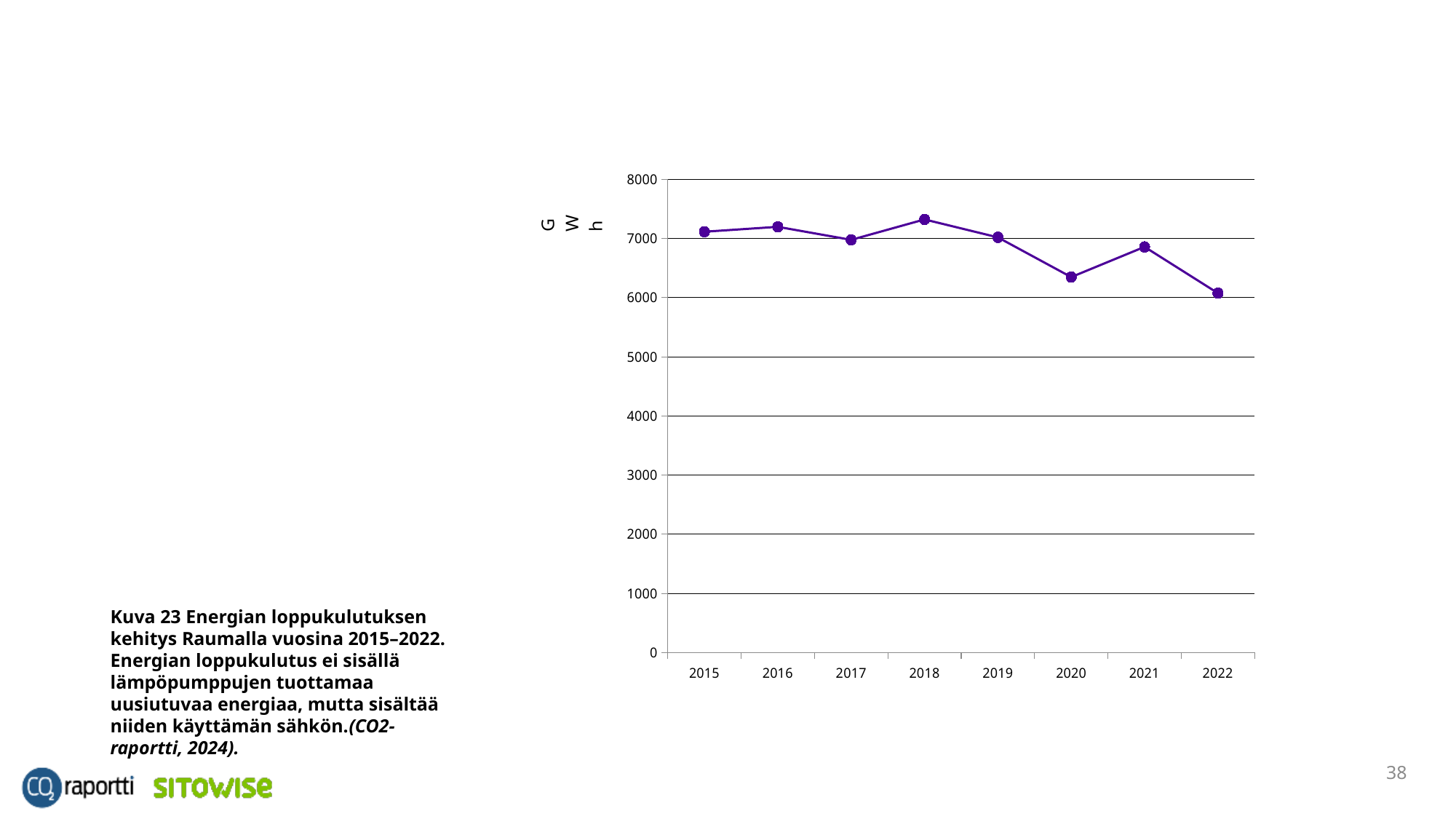
Which year has the highest energy consumption value in the chart? 2018 Is the value for 2018 greater or less than 7000? greater Overall, do the values rise or fall from 2015 to 2022? fall Is the value for 2021 greater or less than 7000? less Is the value for 2020 greater or less than 7000? less What unit is shown on the y axis of the chart? GWh Which year has the lowest energy consumption value in the chart? 2022 Which year has the larger value, 2018 or 2020? 2018 What kind of chart is shown on the slide? line chart Which year has the larger value, 2020 or 2021? 2021 How many years are plotted on the x axis of the chart? 8